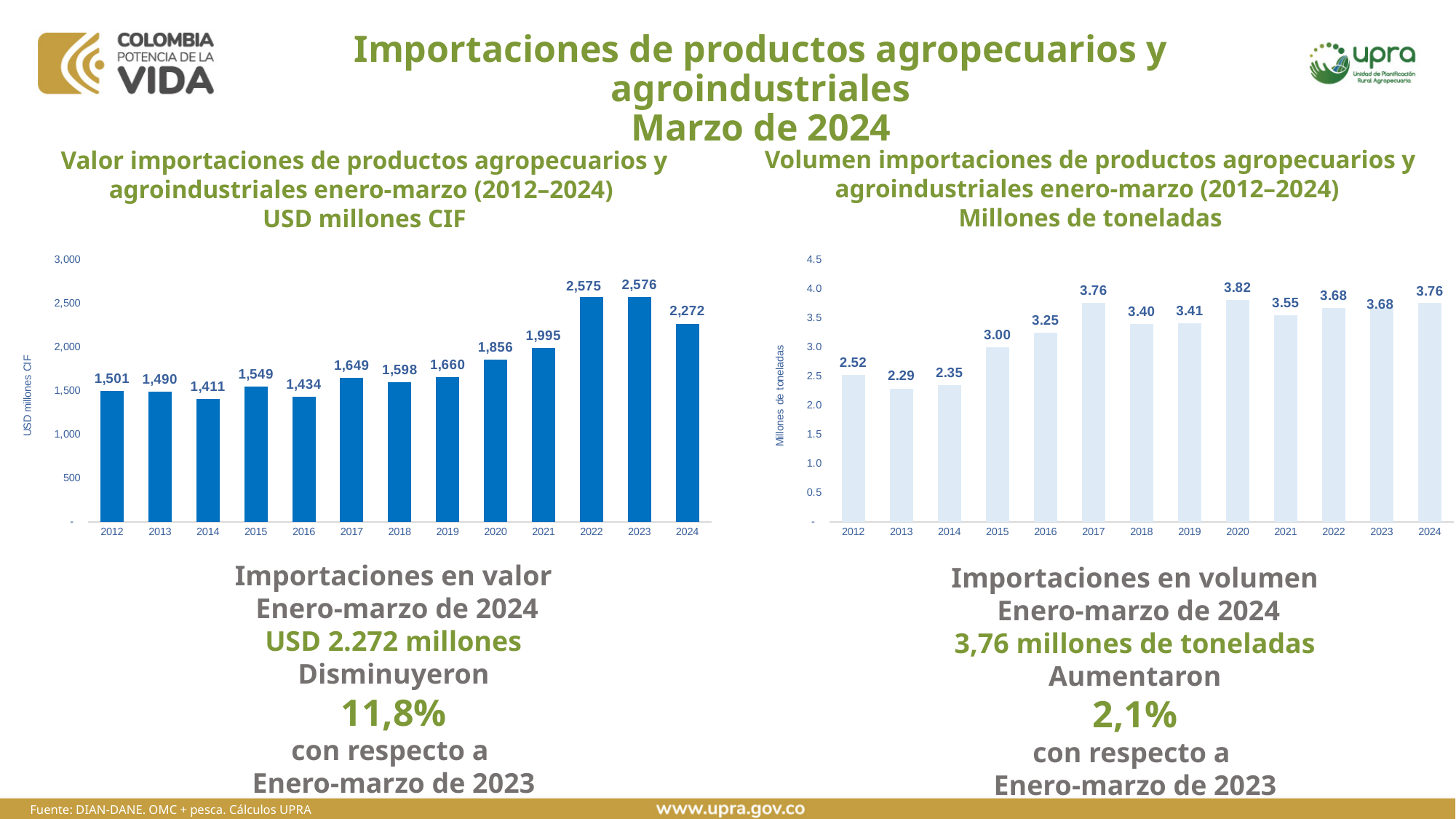
What is the y-axis label of the right chart (Volumen importaciones)? Millones de toneladas How many years are plotted in the left chart (Valor importaciones, USD millones CIF)? 13 In the right chart (Volumen importaciones, Millones de toneladas), what is the difference between the values for 2012 and 2024? 1.24 In the left chart (Valor importaciones, USD millones CIF), what is the value for 2012? 1,501 In the right chart (Volumen importaciones, Millones de toneladas), what is the value for 2013? 2.29 In the right chart (Volumen importaciones, Millones de toneladas), which year has the larger value, 2014 or 2015? 2015 In the left chart (Valor importaciones, USD millones CIF), what is the difference between the values for 2023 and 2024? 304 What type of chart is the right chart (Volumen importaciones, Millones de toneladas)? Bar chart In the right chart (Volumen importaciones, Millones de toneladas), what is the value for 2020? 3.82 In the left chart (Valor importaciones, USD millones CIF), which year has the larger value, 2021 or 2022? 2022 In the left chart (Valor importaciones, USD millones CIF), is the value for 2020 greater or less than 2,000? less In the left chart (Valor importaciones, USD millones CIF), what is the value for 2024? 2,272